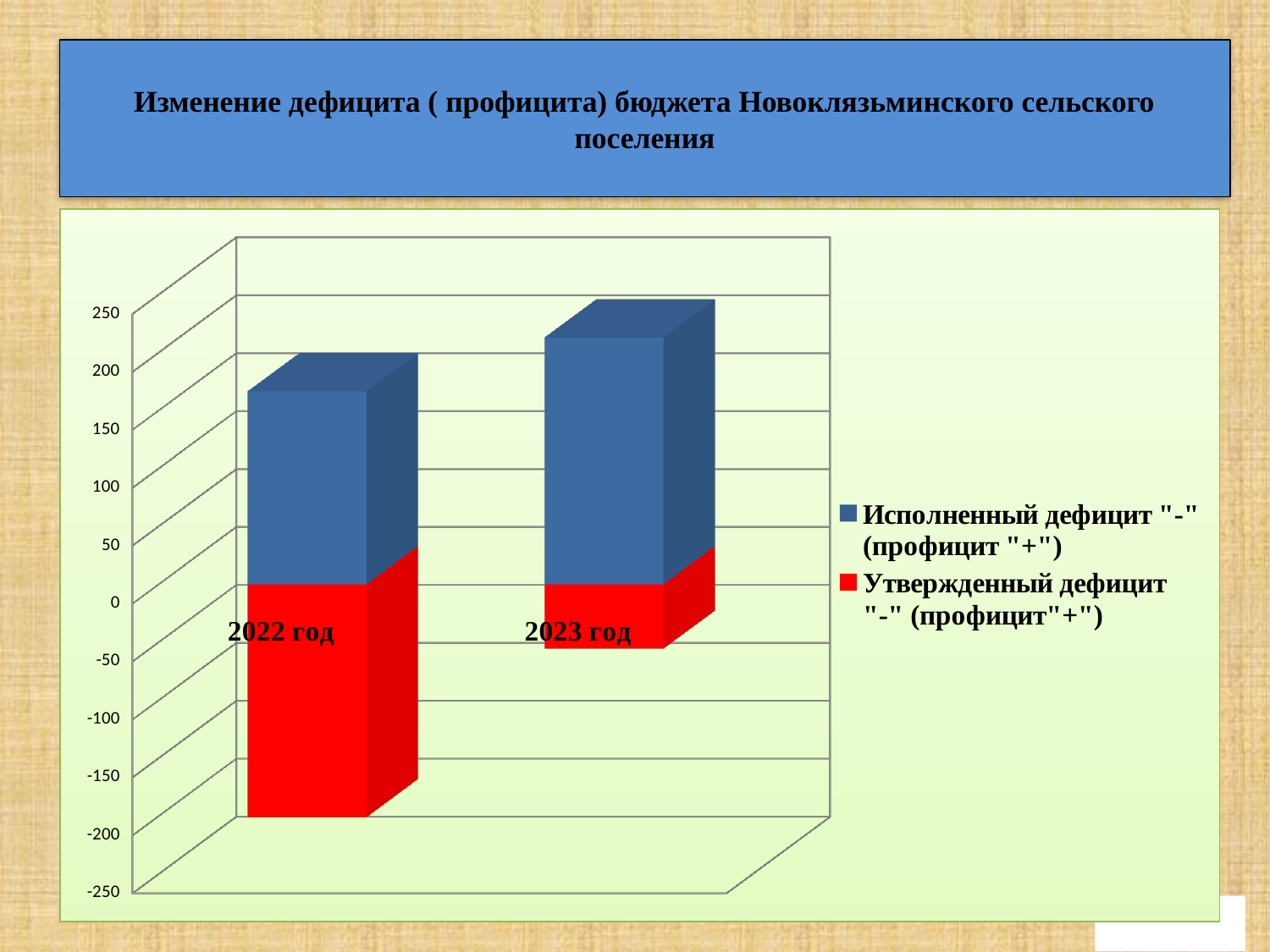
What is the title of the slide containing the chart? Изменение дефицита ( профицита) бюджета Новоклязьминского сельского поселения What kind of chart is shown on the slide? bar chart Is the value for "Утвержденный дефицит "-" (профицит"+")" in 2023 год greater or less than -100? greater Does the value for "Исполненный дефицит "-" (профицит "+")" rise or fall from 2022 год to 2023 год? rise Is the value for "Исполненный дефицит "-" (профицит "+")" in 2022 год greater or less than 150? greater Which year has the higher value for the series "Исполненный дефицит "-" (профицит "+")", 2022 год or 2023 год? 2023 год Is the value for "Утвержденный дефицит "-" (профицит"+")" in 2022 год greater or less than -150? less What colour represents the series "Утвержденный дефицит "-" (профицит"+")" in the chart? red How many categories (years) are shown on the x axis of the chart? 2 How many series does the chart legend list? 2